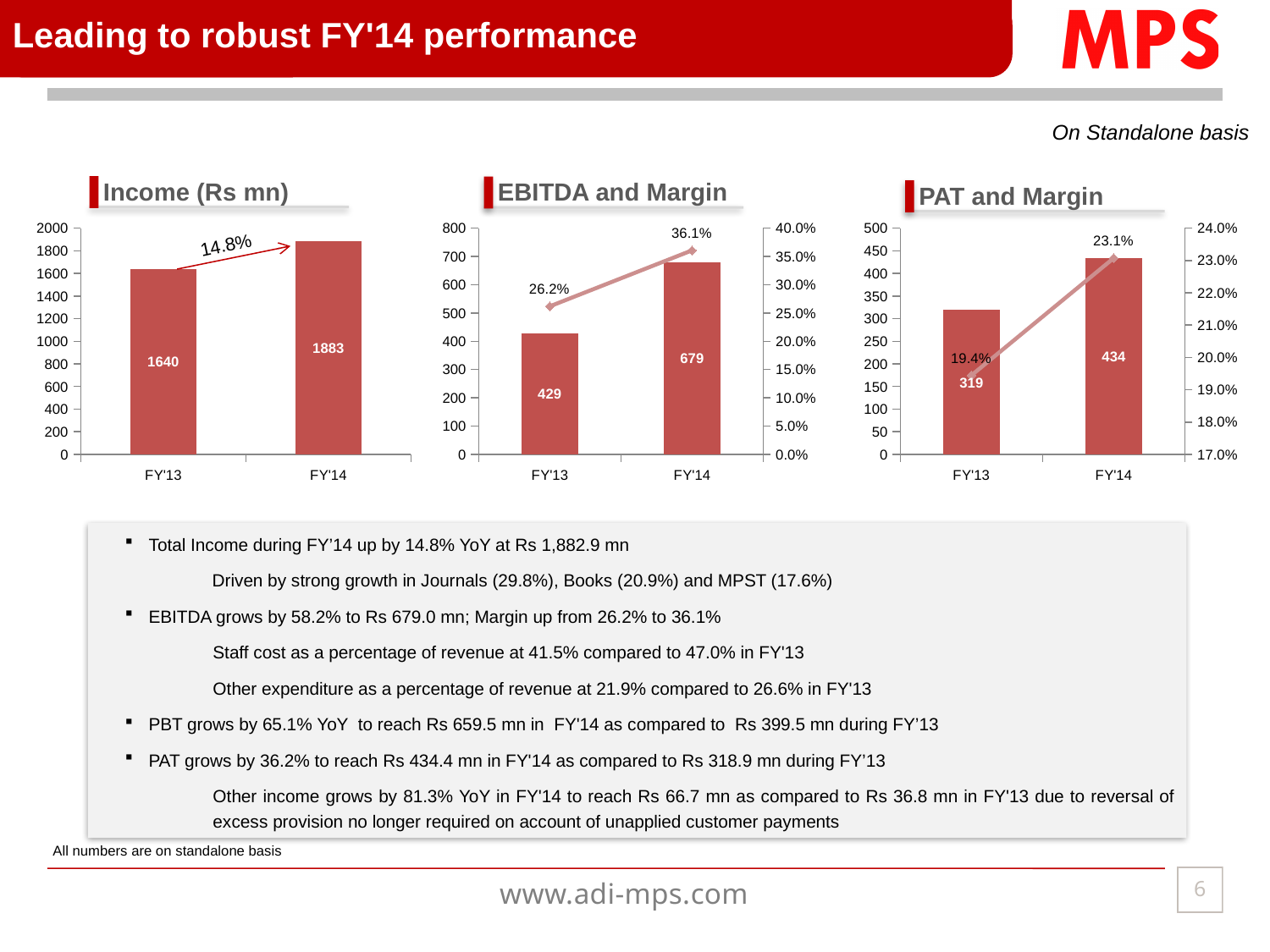
In the Income (Rs mn) chart, what is the value for FY'13? 1640 In the PAT and Margin chart, does the margin rise or fall from FY'13 to FY'14? rise In the EBITDA and Margin chart, what is the EBITDA value for FY'13? 429 In the PAT and Margin chart, which year has the higher PAT value? FY'14 In the Income (Rs mn) chart, what is the difference between the FY'14 and FY'13 values? 243 In the EBITDA and Margin chart, what is the difference between the FY'14 and FY'13 EBITDA values? 250 What type of chart is the Income (Rs mn) chart? bar chart In the PAT and Margin chart, what is the margin for FY'13? 19.4% In the Income (Rs mn) chart, what is the value for FY'14? 1883 In the PAT and Margin chart, what is the PAT value for FY'14? 434 How many categories are shown on the x axis of the Income (Rs mn) chart? 2 In the EBITDA and Margin chart, what is the margin for FY'14? 36.1%